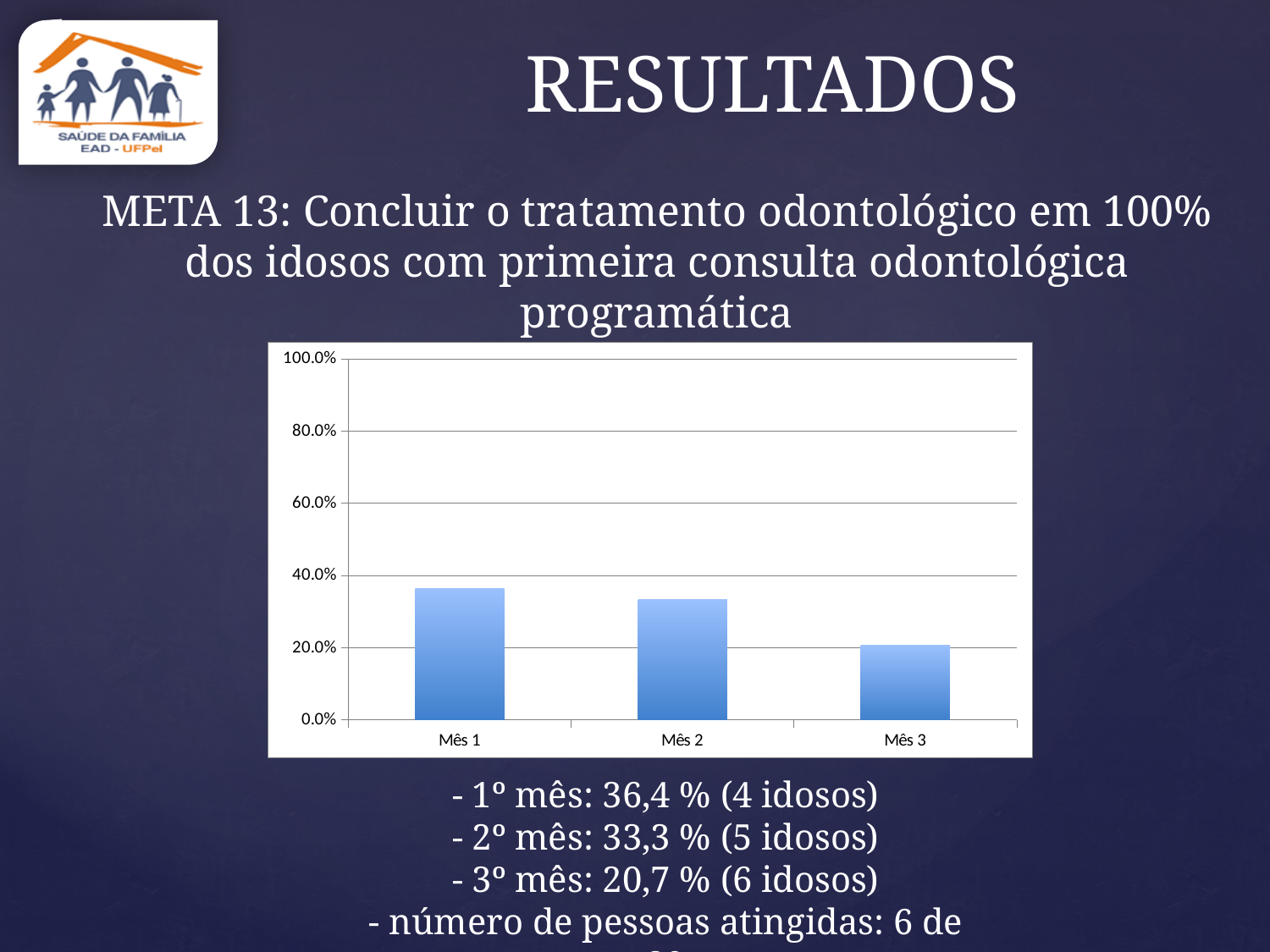
What kind of chart is shown on the slide? bar chart Which month has the highest bar in the chart? Mês 1 Is the value for Mês 1 greater or less than 40.0%? less According to the text below the chart, what percentage was reached in the 3º mês? 20,7 % Is the value for Mês 2 greater or less than 40.0%? less According to the text below the chart, what percentage was reached in the 1º mês? 36,4 % Which month has the lowest bar in the chart? Mês 3 Is the value for Mês 1 greater or less than 20.0%? greater Do the values rise or fall from Mês 1 to Mês 3? fall How many categories (months) are plotted in the chart? 3 Which is larger, the value for Mês 2 or the value for Mês 3? Mês 2